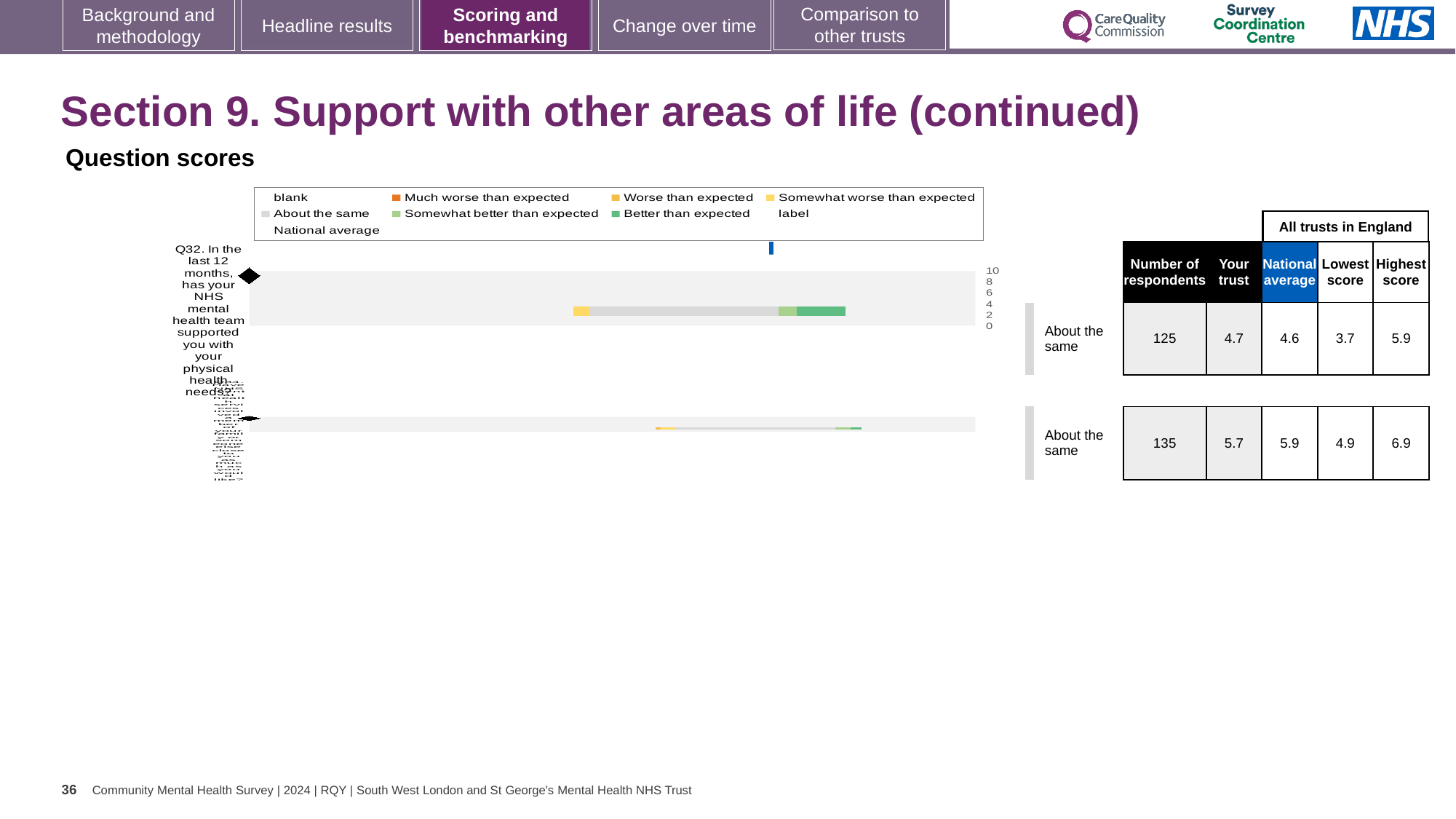
What is the national average for Q32 shown in the table? 4.6 What is the 'Your trust' score for the second question row in the table? 5.7 Which is larger for the second question row: the trust's score or the national average? national average What is the 'Your trust' score for Q32 in the table next to the chart? 4.7 What is the lowest score among all trusts in England for the second question row? 4.9 How many respondents answered Q32? 125 What category label is shown beside both bars in the chart? About the same How many entries does the chart legend list? 9 What is the highest score among all trusts in England for Q32? 5.9 What kind of chart is shown under 'Question scores'? bar chart What is the difference between the number of respondents for the second question row and for Q32? 10 What is the difference between the highest and lowest score for Q32? 2.2